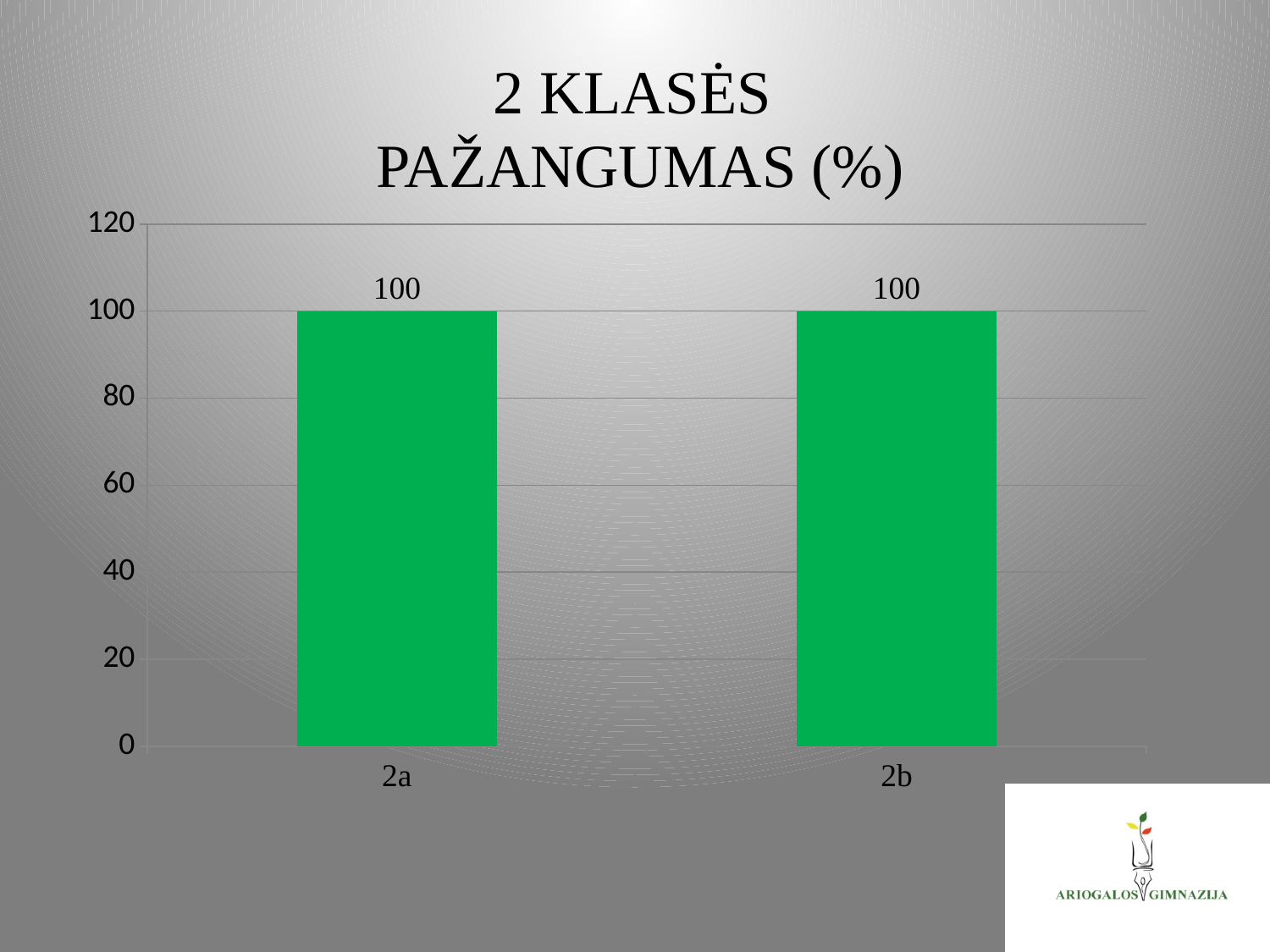
Is the value for 2a greater or less than 80? greater What kind of chart is shown on the slide? bar chart Is the value for 2b greater or less than 120? less What colour are the bars in the chart? green How many categories are shown on the x axis? 2 What is the title of the chart? 2 KLASĖS PAŽANGUMAS (%) What is the value for 2b? 100 What is the highest value shown on the vertical axis? 120 What is the difference between the values for 2a and 2b? 0 Do the values for 2a and 2b differ? No, both are 100 What is the value for 2a? 100